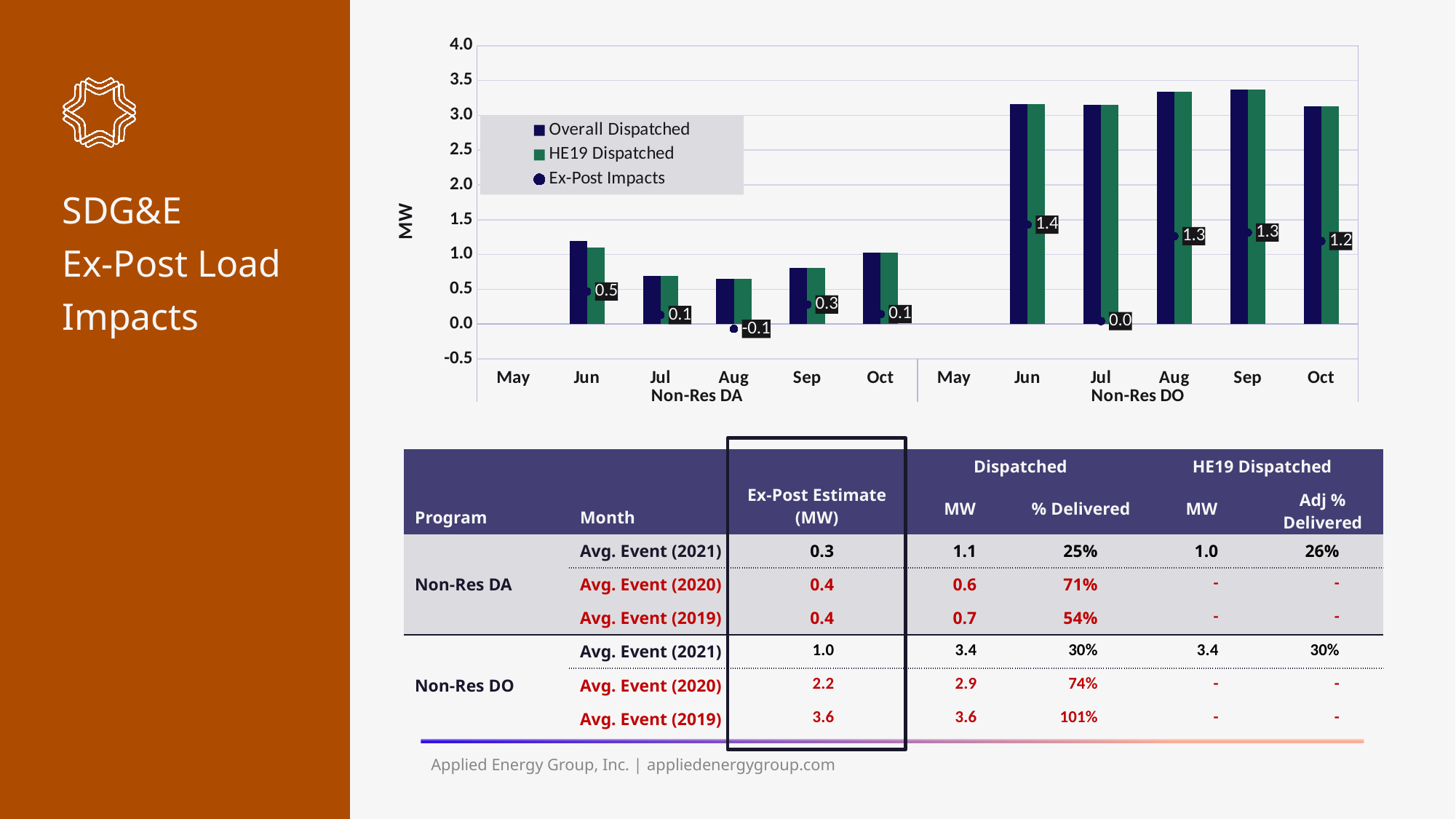
What is the Ex-Post Impacts value for Jul in the Non-Res DO group? 0.0 What is the difference between the Ex-Post Impacts values for Jun and Oct in the Non-Res DO group? 0.2 Which month has the lowest Ex-Post Impacts value in the Non-Res DA group? Aug Is the Overall Dispatched value for Jun in the Non-Res DO group greater or less than 3.0? greater Is the Overall Dispatched value for Sep in the Non-Res DA group greater or less than 1.0? less Which month has the highest Ex-Post Impacts value in the Non-Res DO group? Jun How many series does the chart legend list? 3 What is the label on the vertical axis of the chart? MW What is the Ex-Post Impacts value for Jun in the Non-Res DA group? 0.5 What is the Ex-Post Impacts value for Jun in the Non-Res DO group? 1.4 What is the Ex-Post Impacts value for Aug in the Non-Res DA group? -0.1 Which is larger, the Ex-Post Impacts value for Sep in Non-Res DA or for Sep in Non-Res DO? Sep in Non-Res DO